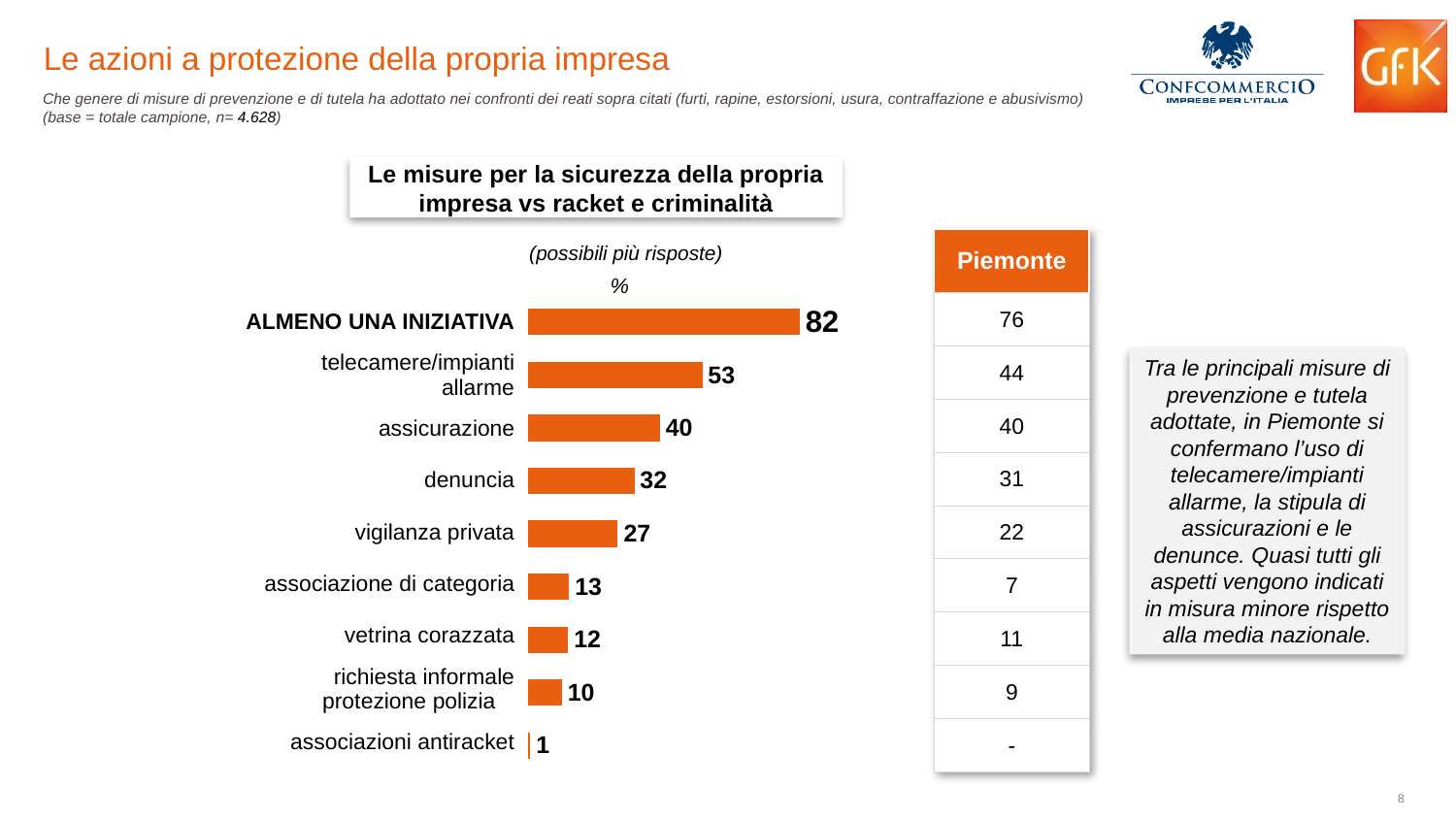
Which is larger, the value for 'denuncia' or 'richiesta informale protezione polizia'? denuncia What is the difference between the values for 'telecamere/impianti allarme' and 'assicurazione'? 13 What is the value for 'telecamere/impianti allarme' in the bar chart? 53 What is the difference between the values for 'denuncia' and 'vigilanza privata'? 5 Which is larger, the value for 'associazione di categoria' or 'vetrina corazzata'? associazione di categoria What kind of chart is shown on the slide? bar chart How many categories are shown in the bar chart? 9 What is the value for 'vigilanza privata' in the bar chart? 27 What is the value for 'assicurazione' in the bar chart? 40 Which category has the lowest value in the bar chart? associazioni antiracket Which category has the highest value in the bar chart? ALMENO UNA INIZIATIVA What is the title of the chart? Le misure per la sicurezza della propria impresa vs racket e criminalità